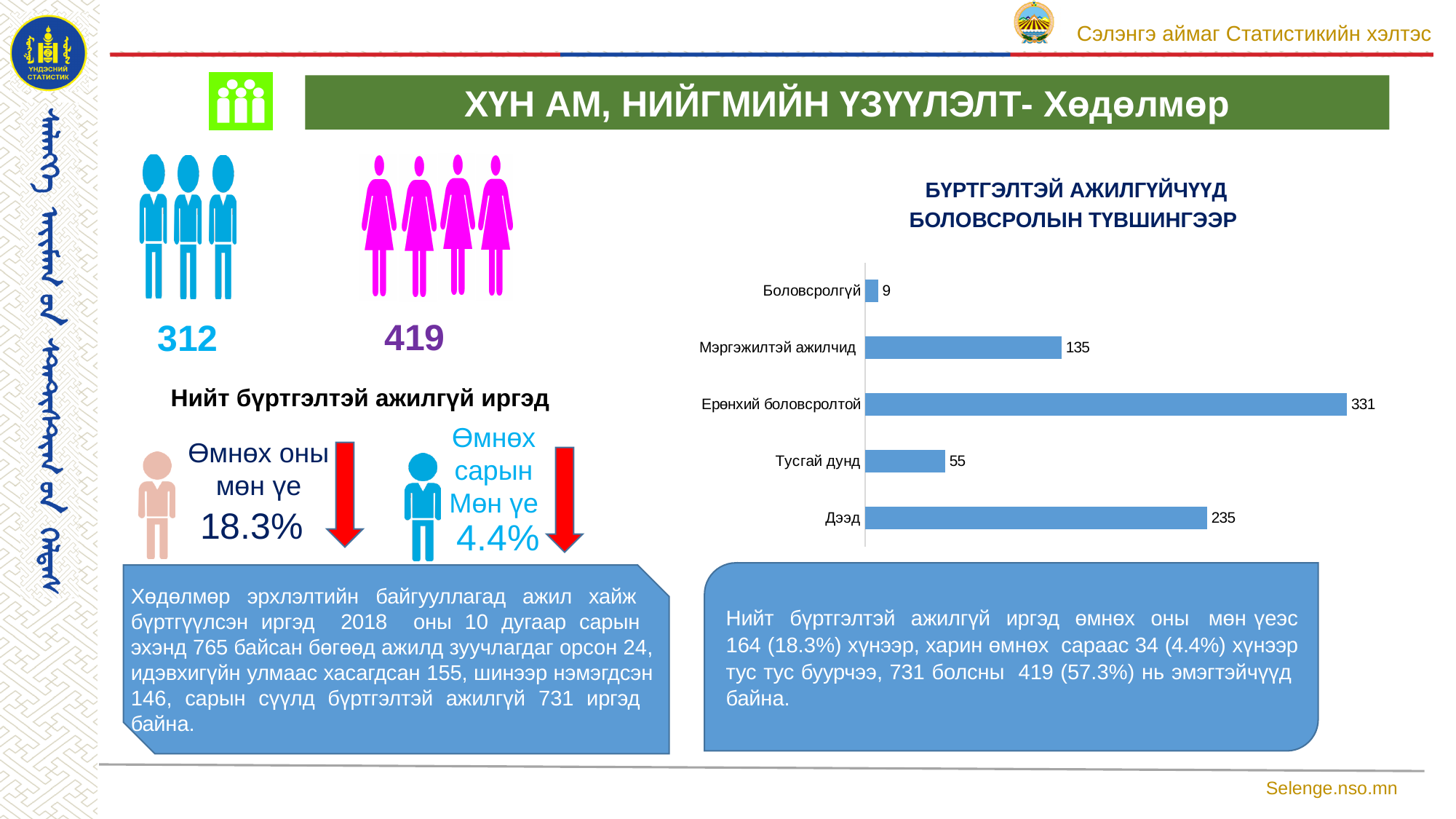
How many categories are shown in the chart? 5 What is the title of the chart? БҮРТГЭЛТЭЙ АЖИЛГҮЙЧҮҮД БОЛОВСРОЛЫН ТҮВШИНГЭЭР What kind of chart is shown on the slide? Bar chart Which category has the lowest value in the chart? Боловсролгүй What is the difference between the values for Мэргэжилтэй ажилчид and Тусгай дунд? 80 What is the value for Тусгай дунд in the chart? 55 What is the value for Боловсролгүй in the chart? 9 Which category has the highest value in the chart? Ерөнхий боловсролтой What is the difference between the values for Ерөнхий боловсролтой and Дээд? 96 Which is larger, the value for Мэргэжилтэй ажилчид or the value for Дээд? Дээд What is the value for Дээд in the chart? 235 What is the value for Ерөнхий боловсролтой in the chart? 331